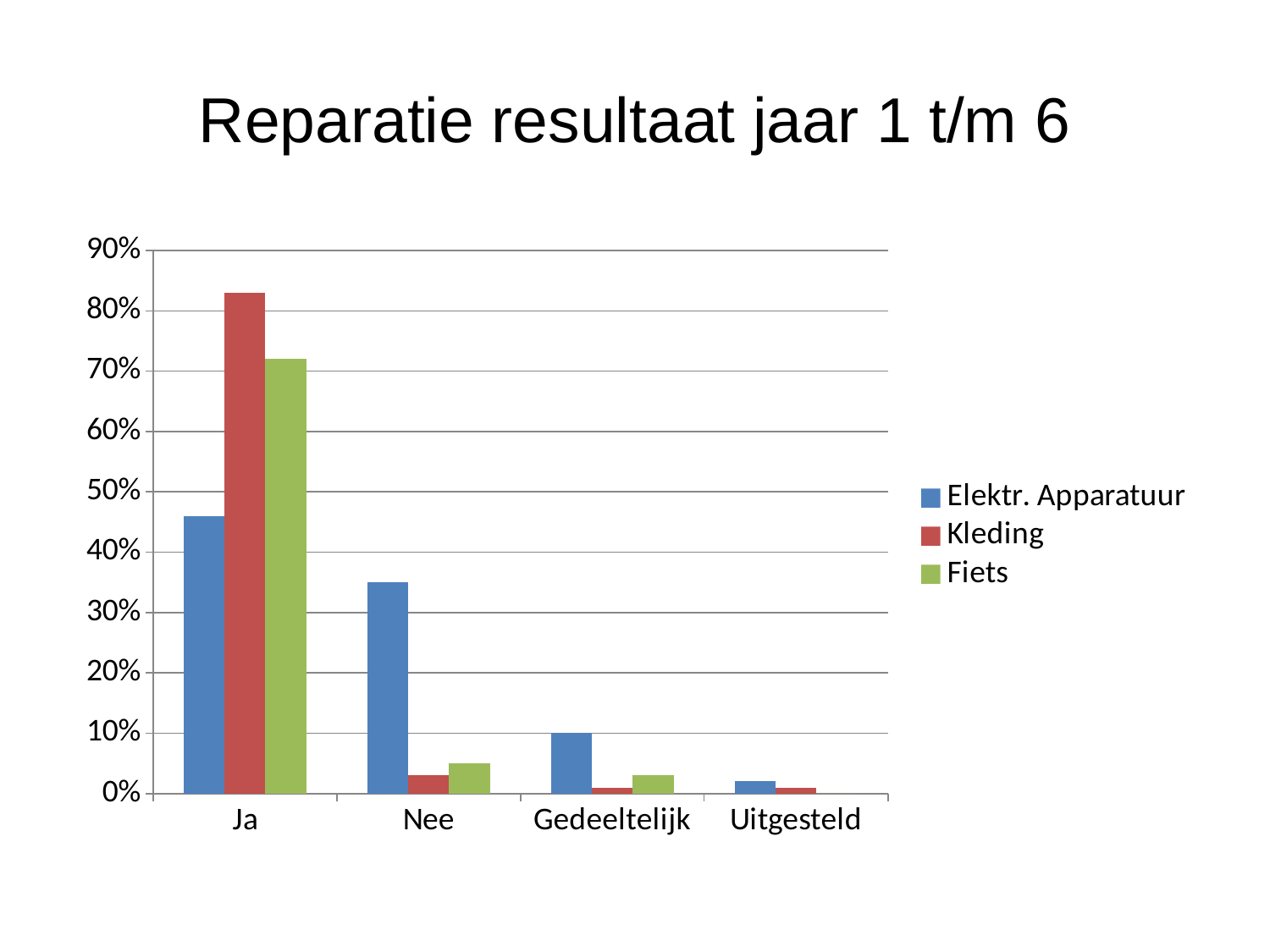
Which series is shown in red? Kleding Which series has the highest value for the category Ja? Kleding How many series does the legend list? 3 How many categories are shown on the x axis? 4 Which series has the highest value for the category Nee? Elektr. Apparatuur What is the title of the chart? Reparatie resultaat jaar 1 t/m 6 Is the value for Fiets in the category Ja greater or less than 70%? greater Is the value for Kleding in the category Ja greater or less than 80%? greater Which series has the lowest value for the category Ja? Elektr. Apparatuur For the category Nee, which is larger: the value for Fiets or the value for Kleding? Fiets What kind of chart is shown on the slide? bar chart Is the value for Elektr. Apparatuur in the category Ja greater or less than 50%? less